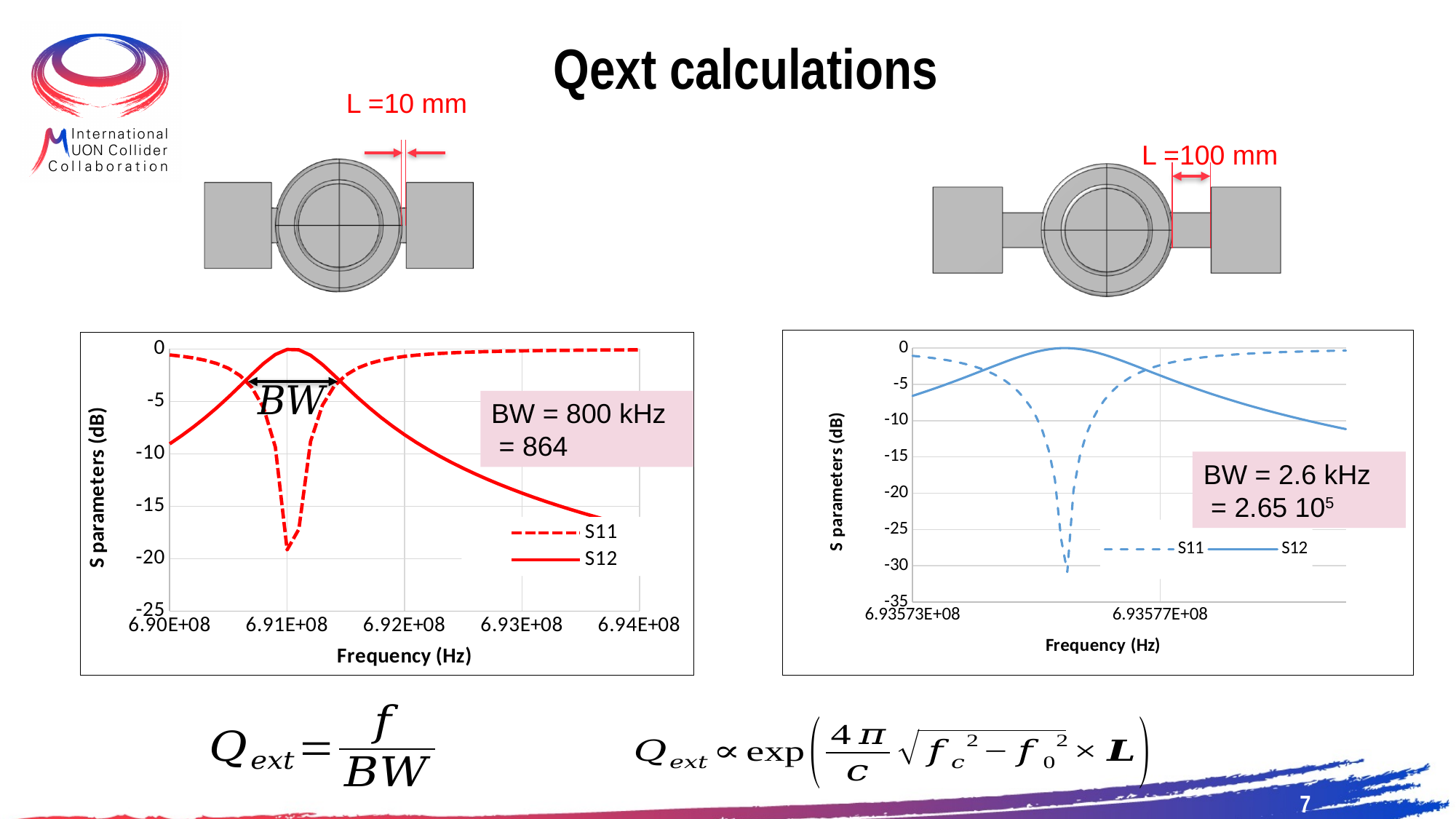
In the right chart, is the value of S12 at the right end of the x axis greater or less than -5? less In the left chart, is the minimum value of S11 greater or less than -20? greater What is the y-axis label of the left chart? S parameters (dB) Which series are listed in the legend of the right chart (L = 100 mm)? S11 and S12 How many series does the legend of the left chart list? 2 In the right chart, which series reaches the lower minimum value, S11 or S12? S11 In the right chart, is the minimum value of S11 greater or less than -25? less What bandwidth (BW) is annotated on the left chart? 800 kHz What kind of chart is the left chart (L = 10 mm)? line chart In the left chart, does S12 rise or fall between 6.92E+08 Hz and 6.94E+08 Hz? fall